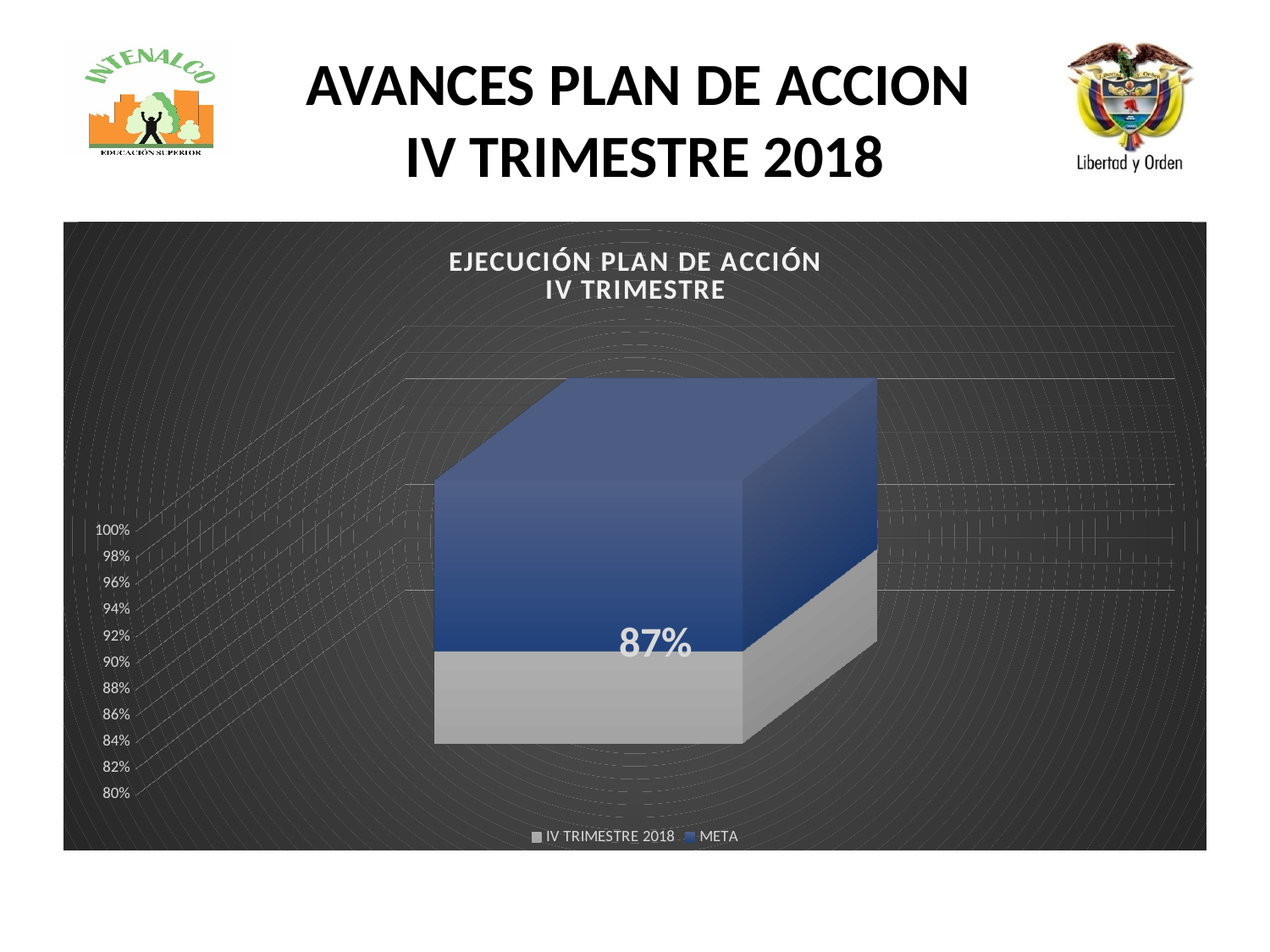
Which series is shown in blue in the chart? META How many series does the chart legend list? 2 What value is shown for IV TRIMESTRE 2018 in the chart? 87% What kind of chart is shown on the slide? bar chart What is the title of the chart? EJECUCIÓN PLAN DE ACCIÓN IV TRIMESTRE Which series has the larger value, IV TRIMESTRE 2018 or META? META Is the value for IV TRIMESTRE 2018 greater or less than 90%? less What is the highest value shown on the chart's vertical axis? 100% What is the lowest value shown on the chart's vertical axis? 80%